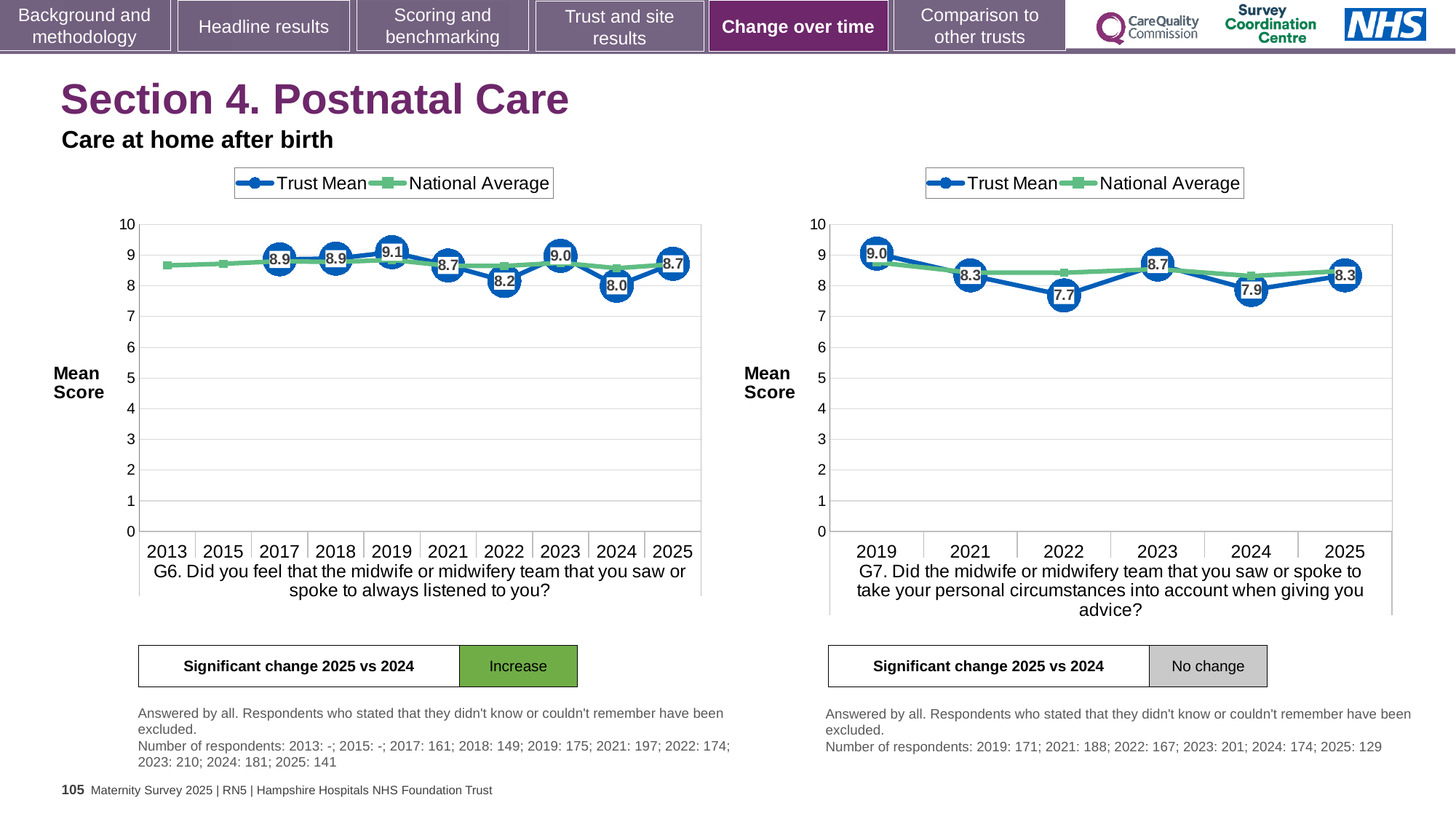
In the right chart (G7), how many years are shown on the x axis? 6 What type of chart is the right chart (G7)? Line chart In the left chart (G6), which year has the lowest Trust Mean score? 2024 In the left chart (G6), which year has the highest Trust Mean score? 2019 In the left chart (G6), what is the Trust Mean score for 2024? 8.0 In the right chart (G7), what is the Trust Mean score for 2022? 7.7 How many series does the legend of the left chart (G6) list? 2 In the left chart (G6), what is the Trust Mean score for 2025? 8.7 In the right chart (G7), which year has the highest Trust Mean score? 2019 In the right chart (G7), which year has the lowest Trust Mean score? 2022 In the right chart (G7), is the Trust Mean score for 2023 larger or smaller than the score for 2024? larger In the left chart (G6), what is the difference between the Trust Mean scores for 2025 and 2024? 0.7